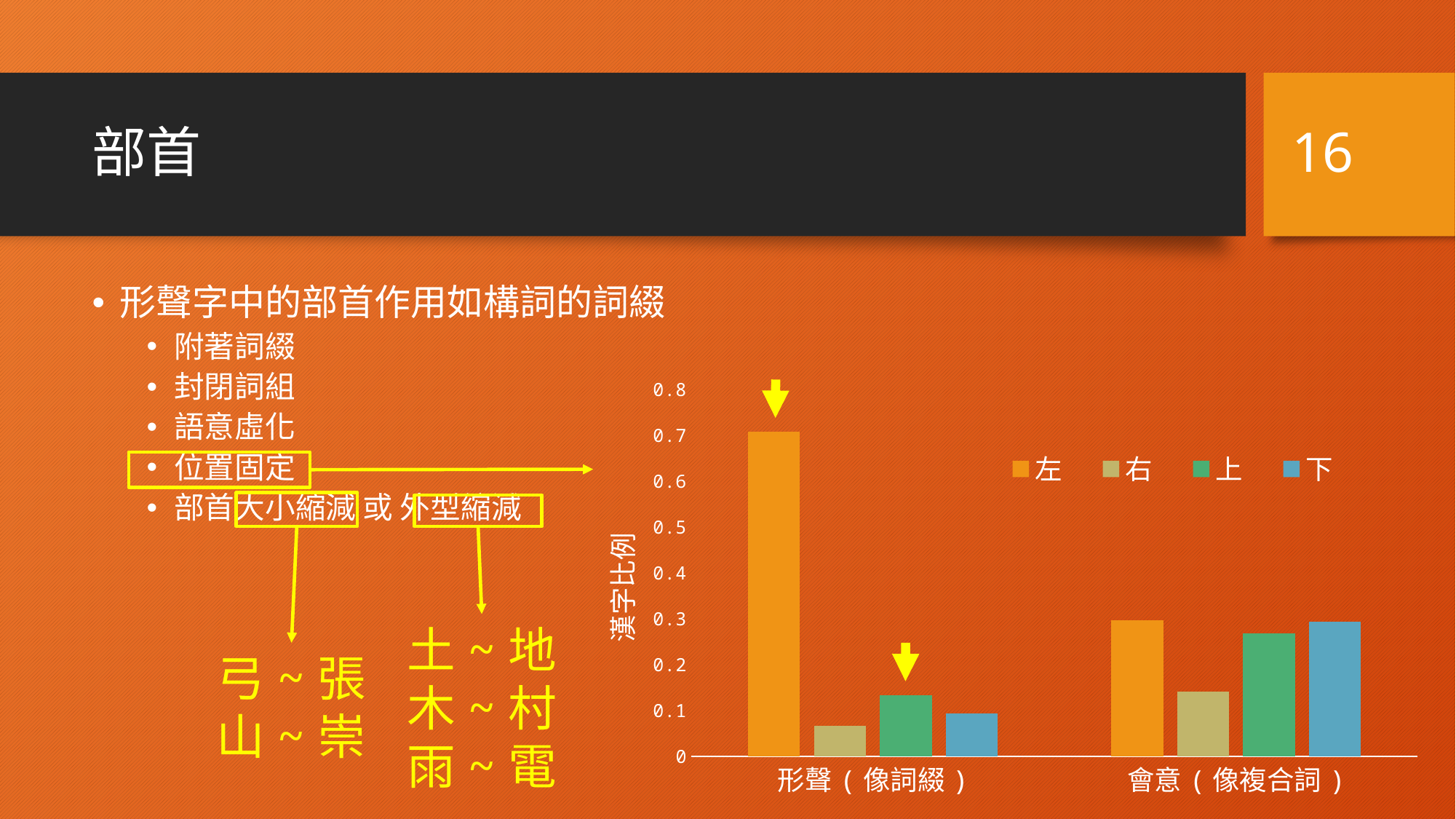
How many series does the chart's legend list? 4 Is the value for 右 in the 形聲（像詞綴） category greater or less than 0.1? less How many categories are shown on the x axis of the chart? 2 Which series has the highest bar in the 形聲（像詞綴） category? 左 Is the value for 左 in the 會意（像複合詞） category greater or less than 0.2? greater What is the title of the chart's vertical axis? 漢字比例 Which series has the lowest bar in the 形聲（像詞綴） category? 右 In the 會意（像複合詞） category, which is larger: 右 or 上? 上 What kind of chart is shown on the slide? bar chart Is the value for 左 in the 形聲（像詞綴） category greater or less than 0.6? greater Which is larger: the 左 value for 形聲（像詞綴） or the 左 value for 會意（像複合詞）? 形聲（像詞綴） In the 形聲（像詞綴） category, which is larger: 上 or 下? 上